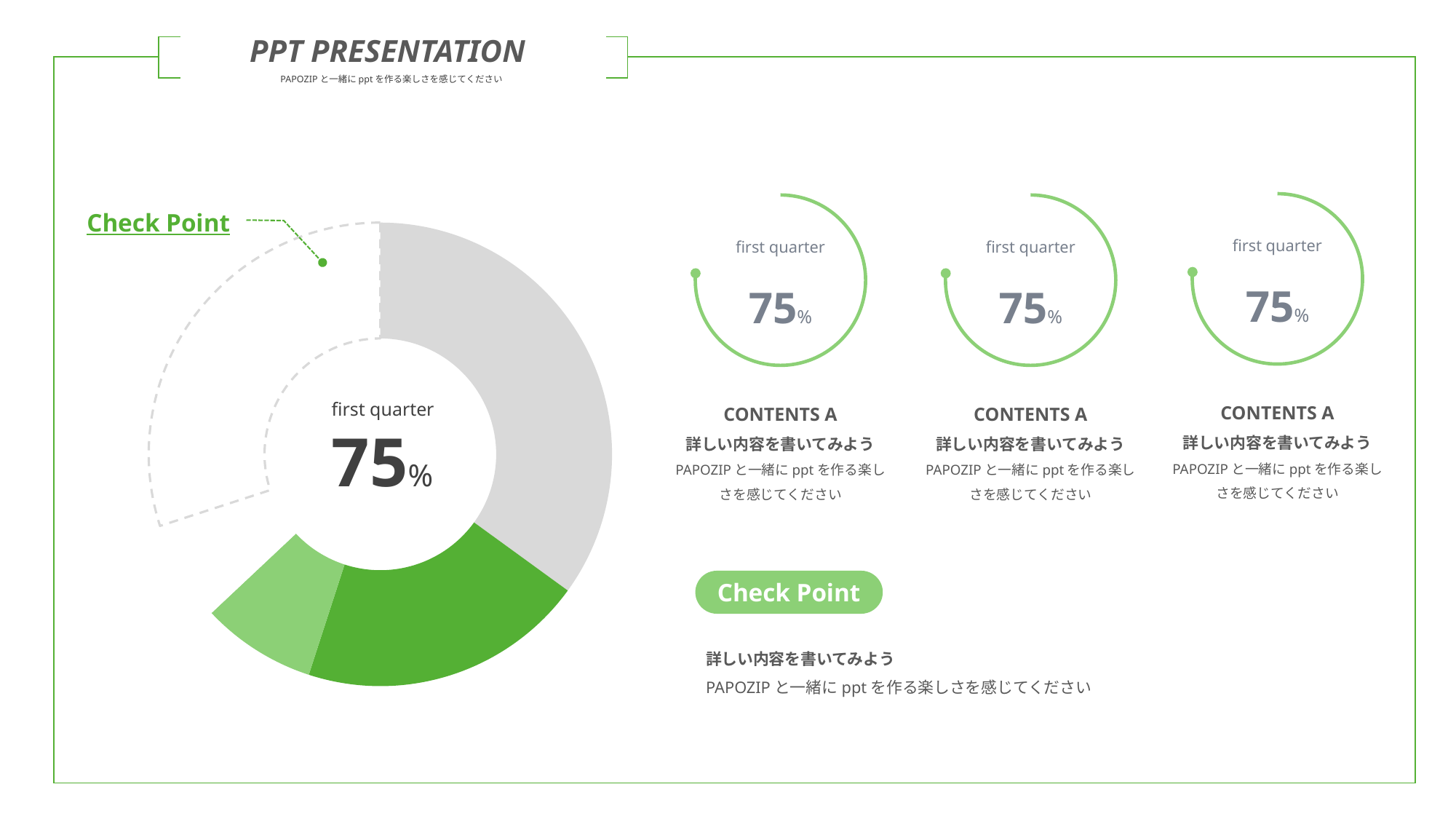
What percentage is printed in the centre of the large donut chart on the left? 75% What label appears above the percentage in the centre of the large donut chart on the left? first quarter How many small ring gauge charts are shown on the right side of the slide? 3 Is the value shown in the centre of the large donut chart greater or less than 50%? greater What percentage is shown in the middle small ring gauge on the right? 75% What colour are the arcs of the three small ring gauges on the right? green What percentage is shown in the first (leftmost) small ring gauge on the right? 75% What label is printed inside each of the three small ring gauges on the right? first quarter What colour is the largest solid segment of the large donut chart on the left? grey What kind of chart is the large chart on the left of the slide? donut chart How many coloured (solid) segments does the large donut chart on the left have? 3 What percentage is shown in the rightmost small ring gauge? 75%